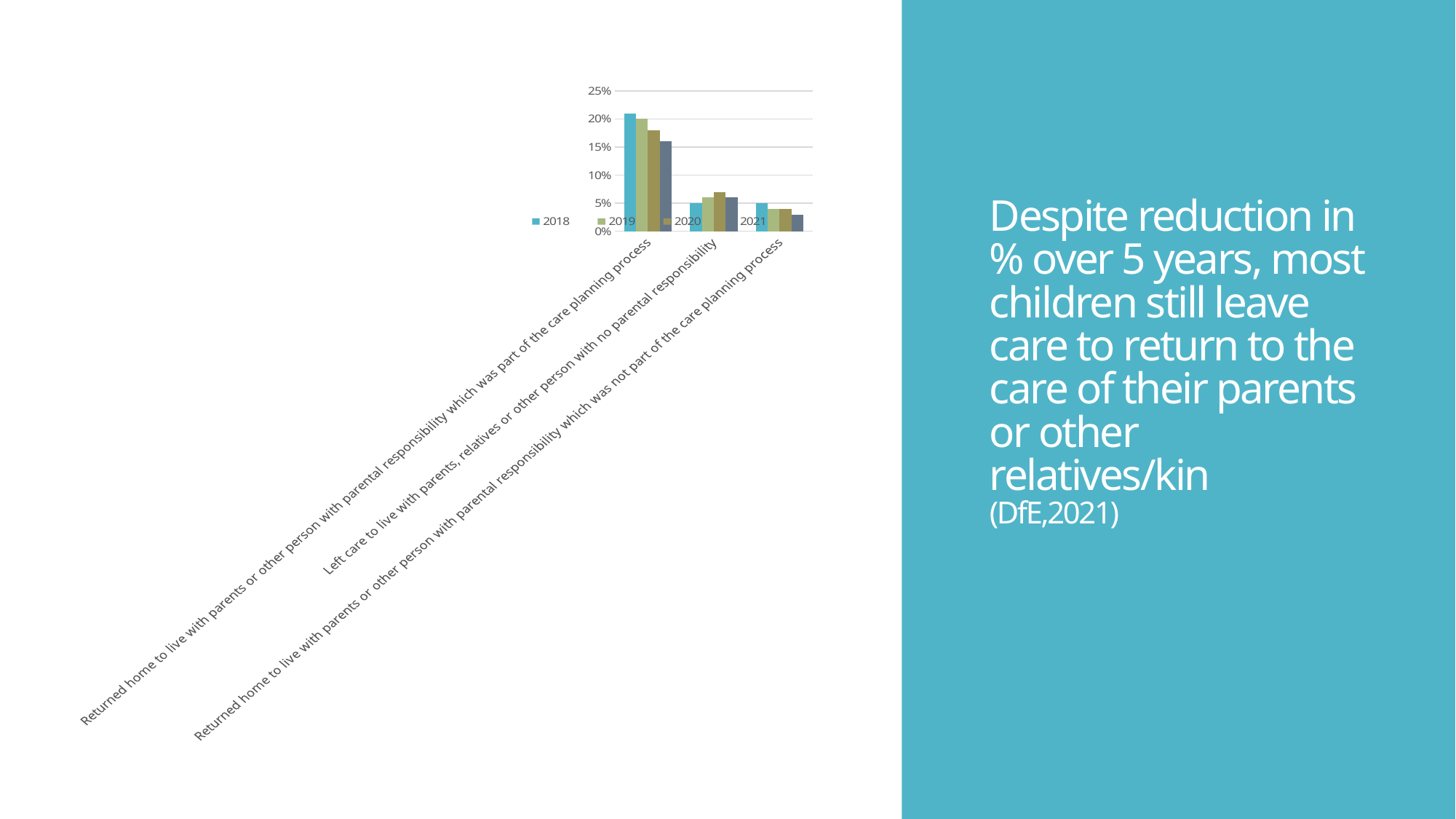
Which years are listed in the chart's legend? 2018, 2019, 2020, 2021 Is the 2021 value for 'Returned home to live with parents or other person with parental responsibility which was part of the care planning process' greater or less than 10%? greater How many categories are shown on the x axis of the chart? 3 Is the 2018 value for 'Returned home to live with parents or other person with parental responsibility which was part of the care planning process' greater or less than 15%? greater What is the highest value shown on the chart's vertical axis? 25% How many series does the chart's legend list? 4 Which category has the highest values in the chart? Returned home to live with parents or other person with parental responsibility which was part of the care planning process Is the 2021 value for 'Returned home to live with parents or other person with parental responsibility which was not part of the care planning process' greater or less than 5%? less What kind of chart is shown on the slide? bar chart For 'Returned home to live with parents or other person with parental responsibility which was part of the care planning process', which is larger: the 2018 value or the 2021 value? 2018 Do the values for 'Returned home to live with parents or other person with parental responsibility which was part of the care planning process' rise or fall from 2018 to 2021? fall